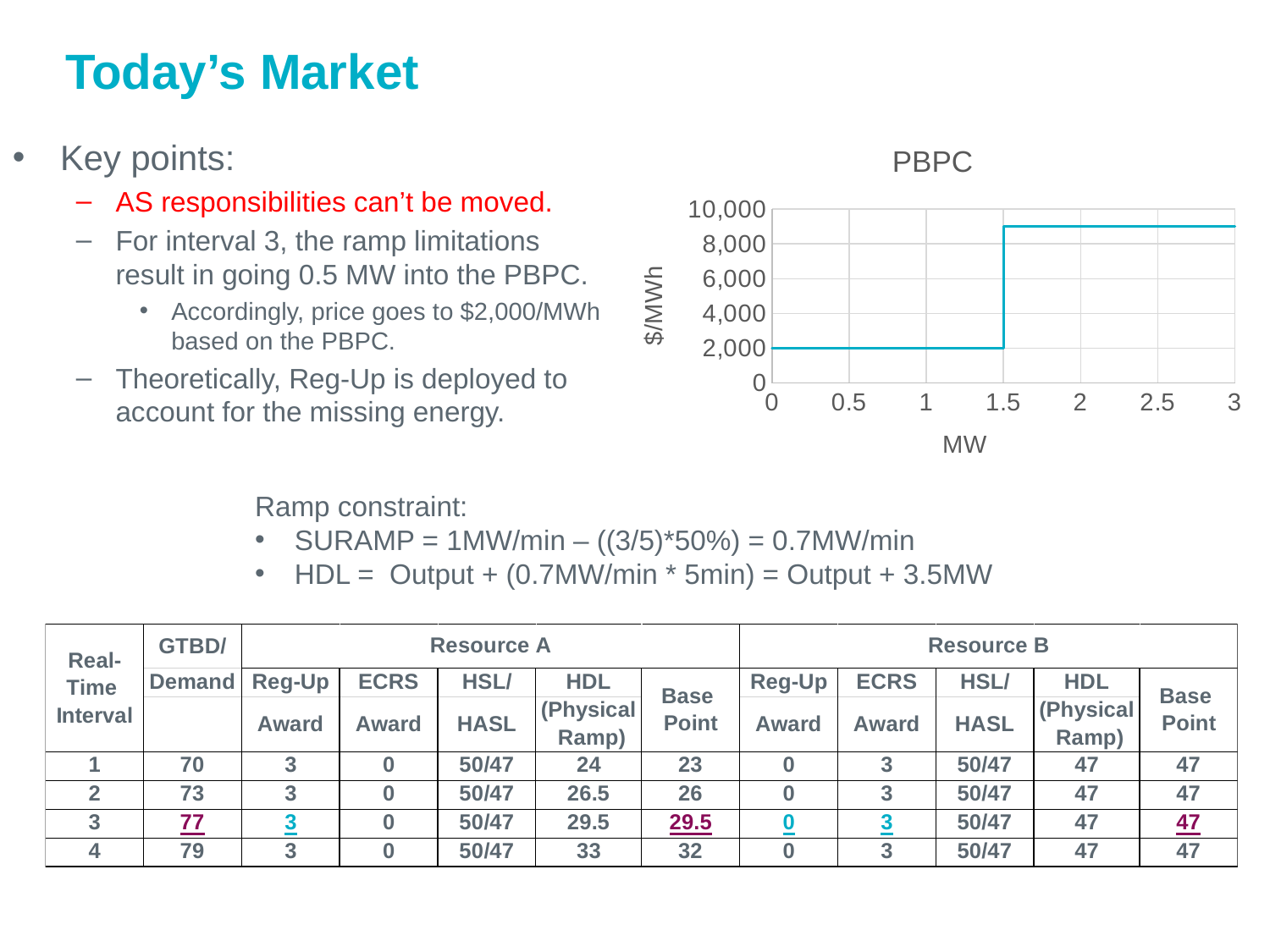
On the PBPC chart, is the value at 2 MW greater or less than 8,000? greater What is the title of the chart on the slide? PBPC What is the label of the y axis on the PBPC chart? $/MWh On the PBPC chart, what is the price in $/MWh at 1 MW? 2,000 On the PBPC chart, is the value at 2.5 MW greater or less than 10,000? less On the PBPC chart, at what MW value does the price step up? 1.5 On the PBPC chart, which is larger: the value at 1 MW or the value at 2 MW? the value at 2 MW On the PBPC chart, what is the price in $/MWh at 0.5 MW? 2,000 On the PBPC chart, does the price rise or fall as MW increases from 0 to 3? rise What is the highest value shown on the y axis of the PBPC chart? 10,000 What kind of chart is the PBPC chart? line chart On the PBPC chart, is the value at 1 MW greater or less than 4,000? less